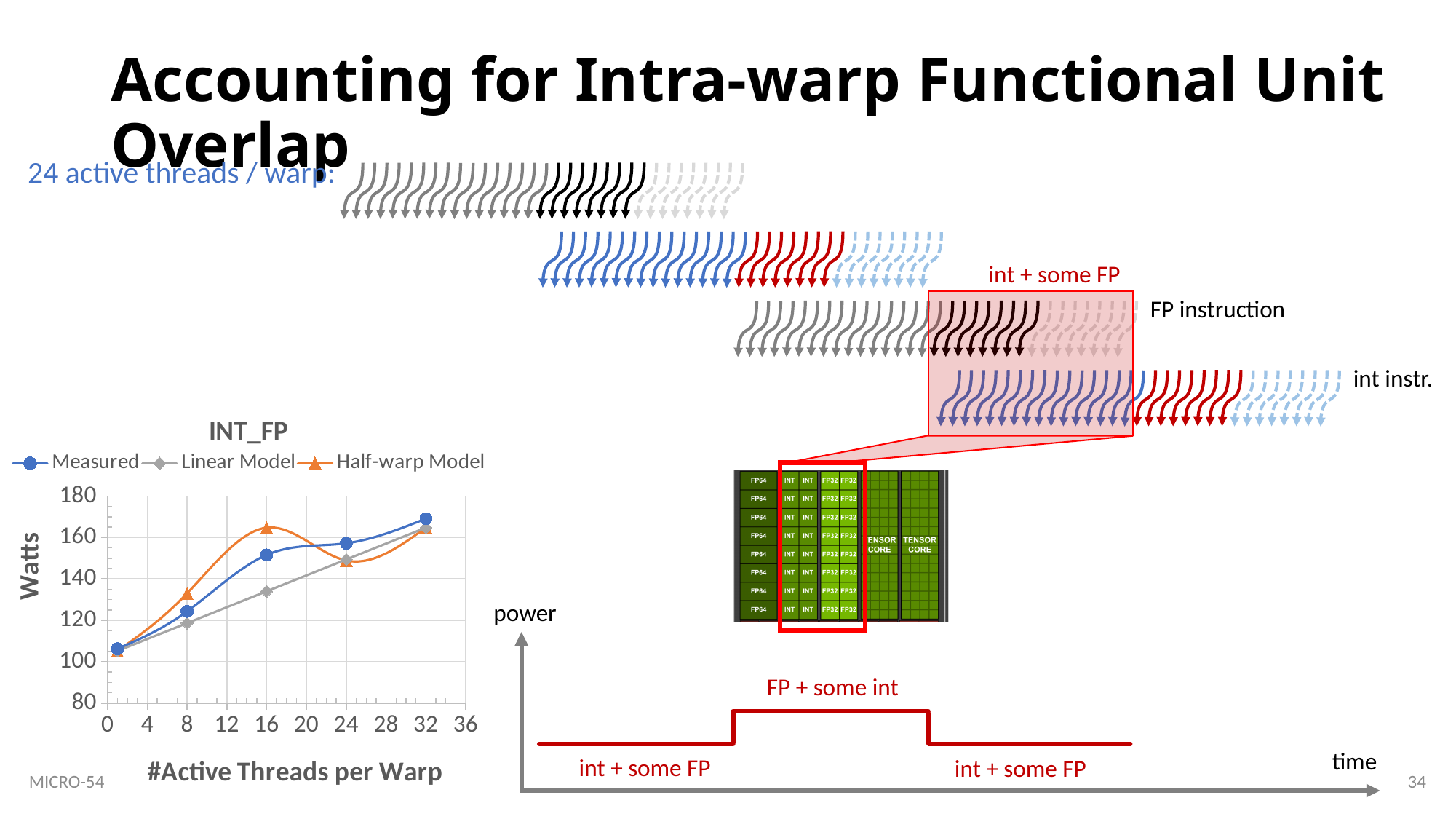
In the INT_FP chart, at 24 active threads per warp, which is larger: Measured or Half-warp Model? Measured In the INT_FP chart, is the Measured value at 16 active threads per warp greater or less than 140? greater What is the y-axis label of the INT_FP chart? Watts In the INT_FP chart, is the Half-warp Model value at 16 active threads per warp greater or less than 160? greater In the INT_FP chart, is the Linear Model value at 16 active threads per warp greater or less than 140? less In the INT_FP chart, does the Linear Model series rise or fall as the number of active threads per warp increases? rise What kind of chart is the INT_FP chart? line chart How many series does the legend of the INT_FP chart list? 3 In the INT_FP chart, which series has the highest value at 16 active threads per warp? Half-warp Model What are the series names in the legend of the INT_FP chart? Measured, Linear Model, Half-warp Model How many data points does the Measured series have in the INT_FP chart? 5